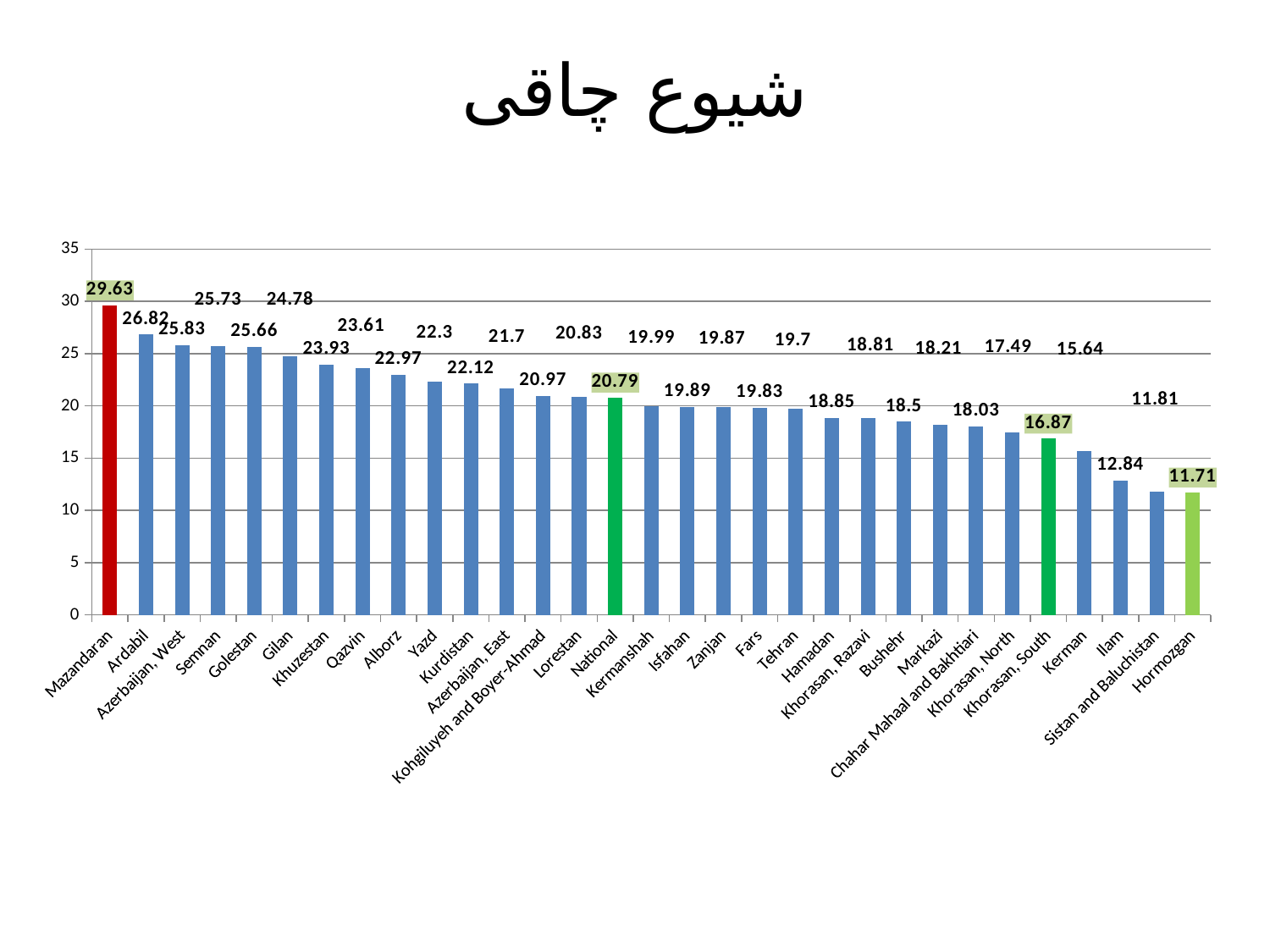
What is the value for National? 20.79 What is the difference between the values for Ardabil and Ilam? 13.98 Which category has the highest value? Mazandaran Is the value for Kerman greater or less than 15? greater How many bars are shown in the chart? 31 Which category has the lowest value? Hormozgan Do the values rise or fall from left to right along the x axis? fall Which has a larger value, Isfahan or Tehran? Isfahan What is the value for Mazandaran? 29.63 What is the value for Khorasan, South? 16.87 What is the difference between the values for Mazandaran and Hormozgan? 17.92 What kind of chart is shown on the slide? bar chart